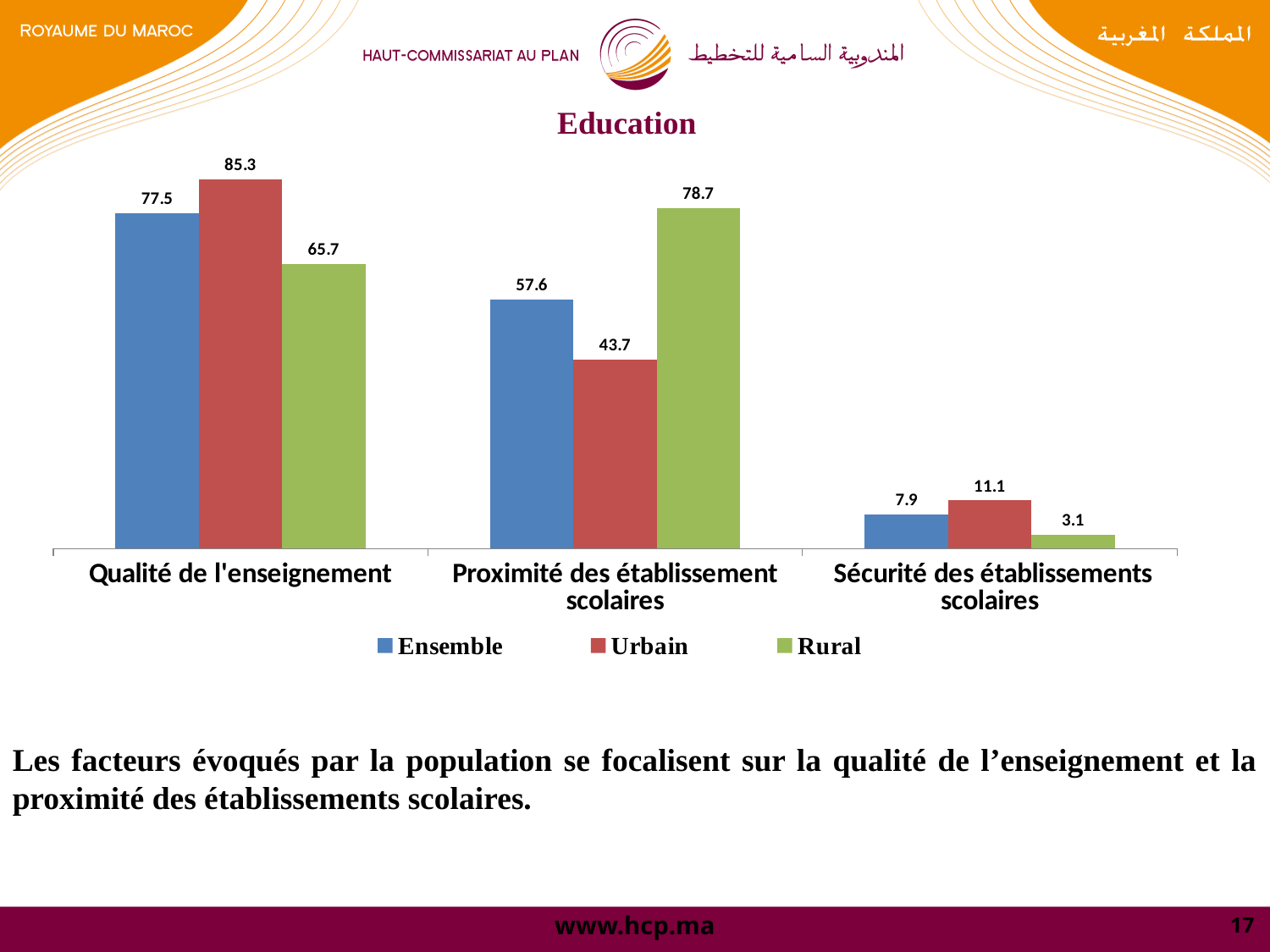
How many categories are shown on the x axis? 3 Which category has the highest Ensemble value? Qualité de l'enseignement What is the difference between the Urbain and Rural values for Qualité de l'enseignement? 19.6 How many series does the legend list? 3 What is the Rural value for Proximité des établissement scolaires? 78.7 What is the Ensemble value for Sécurité des établissements scolaires? 7.9 What is the Urbain value for Qualité de l'enseignement? 85.3 What is the difference between the Rural and Urbain values for Proximité des établissement scolaires? 35 What kind of chart is shown on the slide? Bar chart For Proximité des établissement scolaires, which is larger: the Ensemble value or the Urbain value? Ensemble Which category has the lowest Rural value? Sécurité des établissements scolaires What is the title of the chart? Education